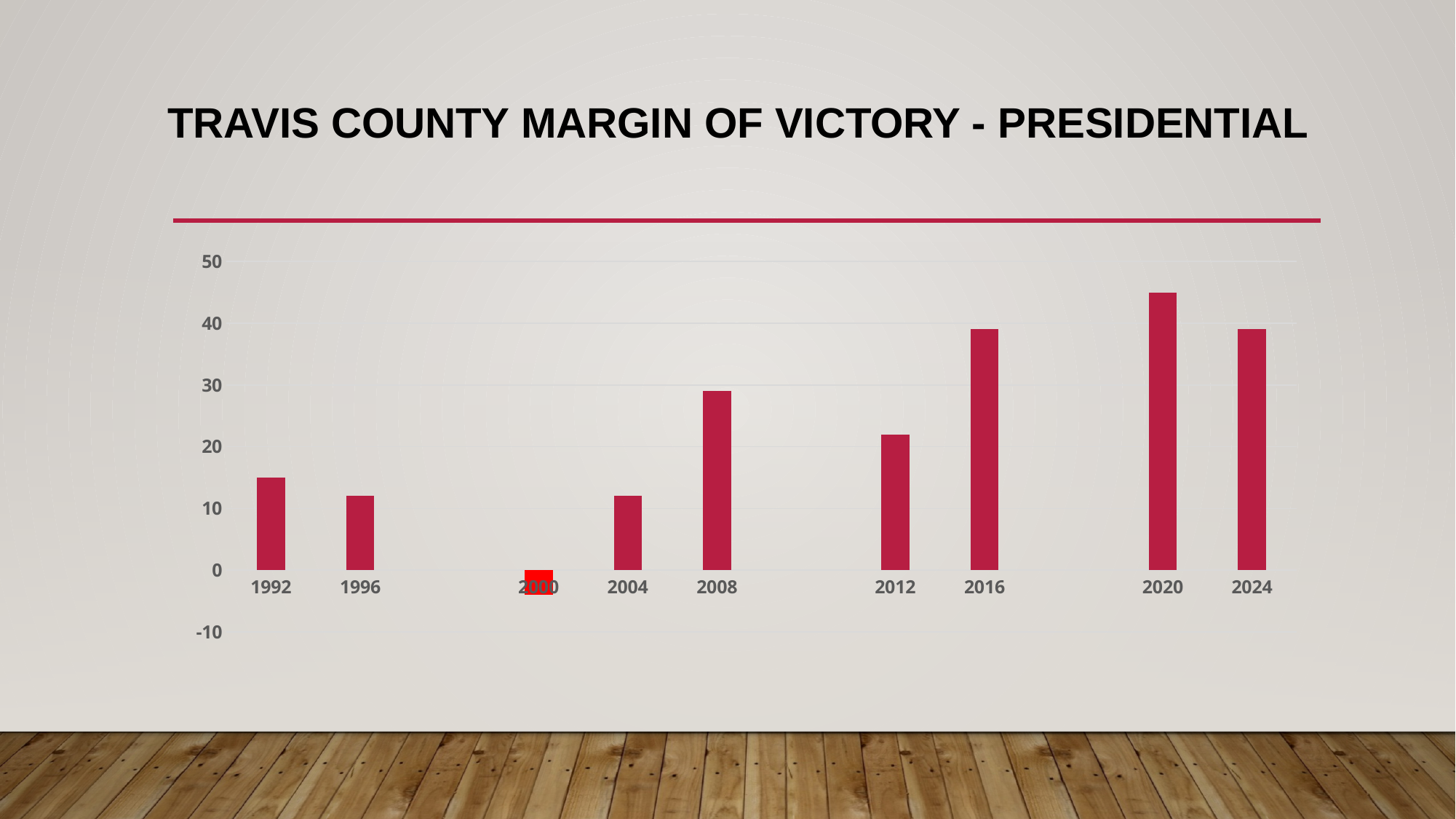
What is the title of the chart? Travis County Margin of Victory - Presidential Is the value for 2020 greater or less than 40? greater Which year has the highest margin of victory in the chart? 2020 Is the value for 2000 greater or less than 0? less Do the values generally rise or fall from 2004 to 2020? rise Which year has the lowest margin of victory in the chart? 2000 What kind of chart is shown on the slide? bar chart Is the value for 2012 greater or less than 20? greater Which is larger, the value for 2008 or the value for 2012? 2008 How many election years are shown on the x axis of the chart? 9